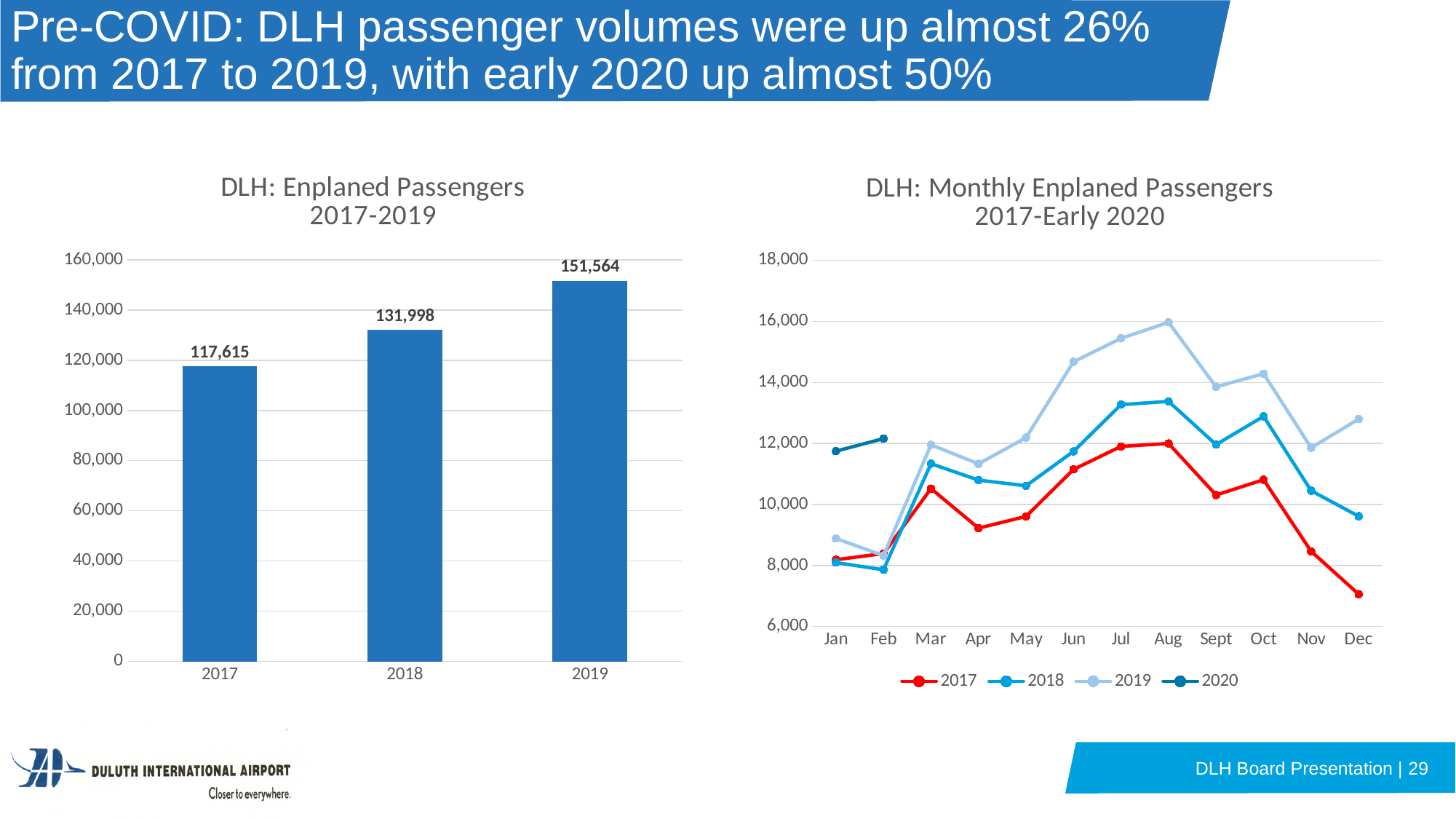
In the 'DLH: Enplaned Passengers 2017-2019' chart, what is the value for 2018? 131,998 In the 'DLH: Enplaned Passengers 2017-2019' chart, how many bars are shown? 3 What kind of chart is 'DLH: Enplaned Passengers 2017-2019'? bar chart In the 'DLH: Monthly Enplaned Passengers 2017-Early 2020' chart, is the 2017 value for Dec greater or less than 8,000? less In the 'DLH: Enplaned Passengers 2017-2019' chart, what is the difference between the 2019 and 2017 values? 33,949 In the 'DLH: Monthly Enplaned Passengers 2017-Early 2020' chart, how many months are shown on the x axis? 12 In the 'DLH: Monthly Enplaned Passengers 2017-Early 2020' chart, does the 2017 series rise or fall from Aug to Dec? fall In the 'DLH: Monthly Enplaned Passengers 2017-Early 2020' chart, how many series does the legend list? 4 In the 'DLH: Monthly Enplaned Passengers 2017-Early 2020' chart, which is larger in Jun: the 2019 value or the 2018 value? 2019 In the 'DLH: Monthly Enplaned Passengers 2017-Early 2020' chart, in which month does the 2019 series reach its highest value? Aug In the 'DLH: Enplaned Passengers 2017-2019' chart, which year has the lowest value? 2017 In the 'DLH: Enplaned Passengers 2017-2019' chart, which year has the highest value? 2019